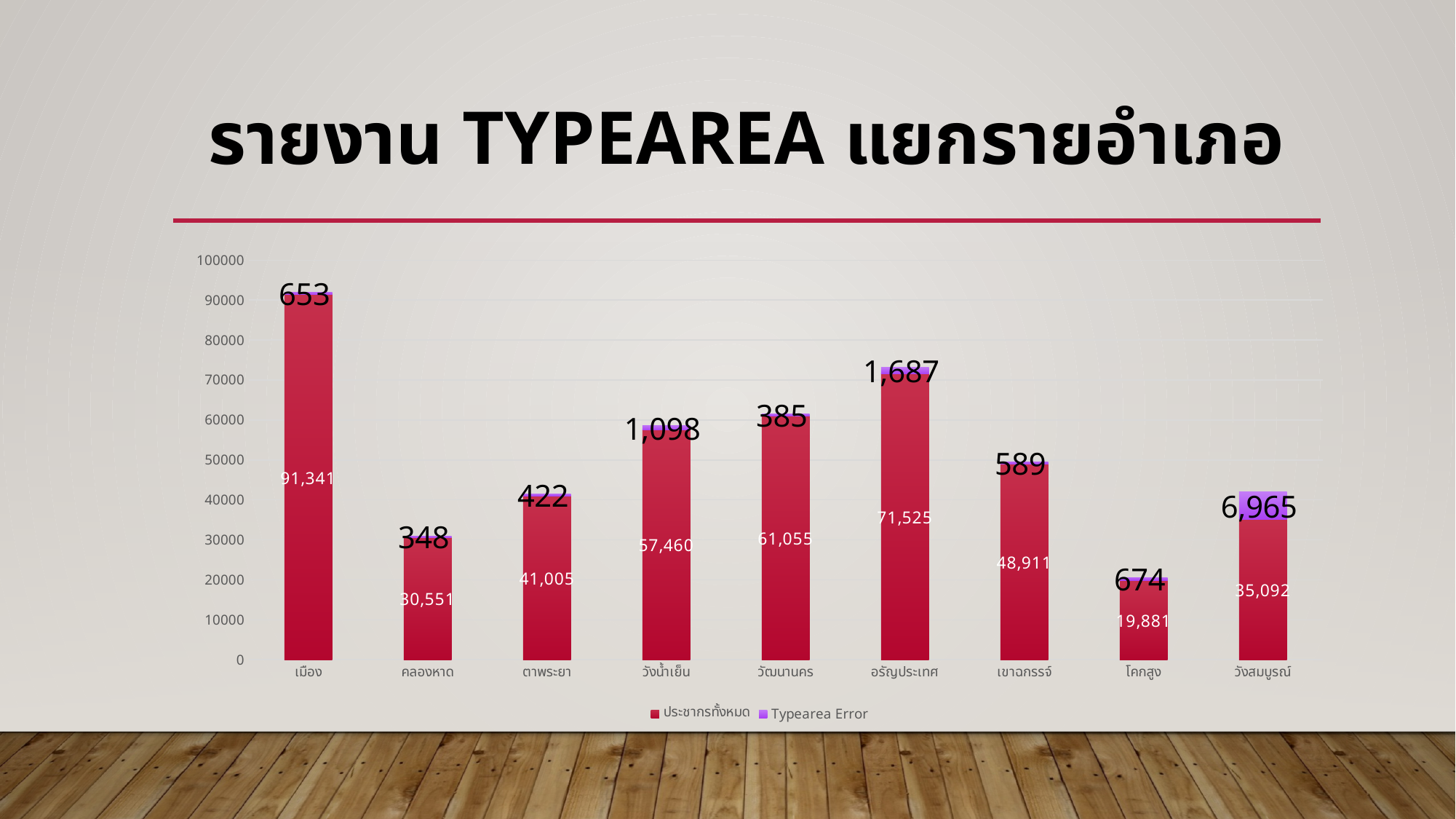
Which category has the lowest Typearea Error value? คลองหาด Which has a larger Typearea Error value, วังน้ำเย็น or เขาฉกรรจ์? วังน้ำเย็น How many categories are shown on the x axis? 9 Which category has the highest ประชากรทั้งหมด value? เมือง Is the total stacked value for ตาพระยา greater or less than 40000? greater What is the ประชากรทั้งหมด value for อรัญประเทศ? 71,525 What kind of chart is shown on the slide? Stacked bar chart What is the Typearea Error value for วังสมบูรณ์? 6,965 What is the total of the stacked bar for วังสมบูรณ์? 42,057 What is the difference between the ประชากรทั้งหมด values for วัฒนานคร and วังน้ำเย็น? 3,595 How many series does the legend list? 2 What is the ประชากรทั้งหมด value for โคกสูง? 19,881